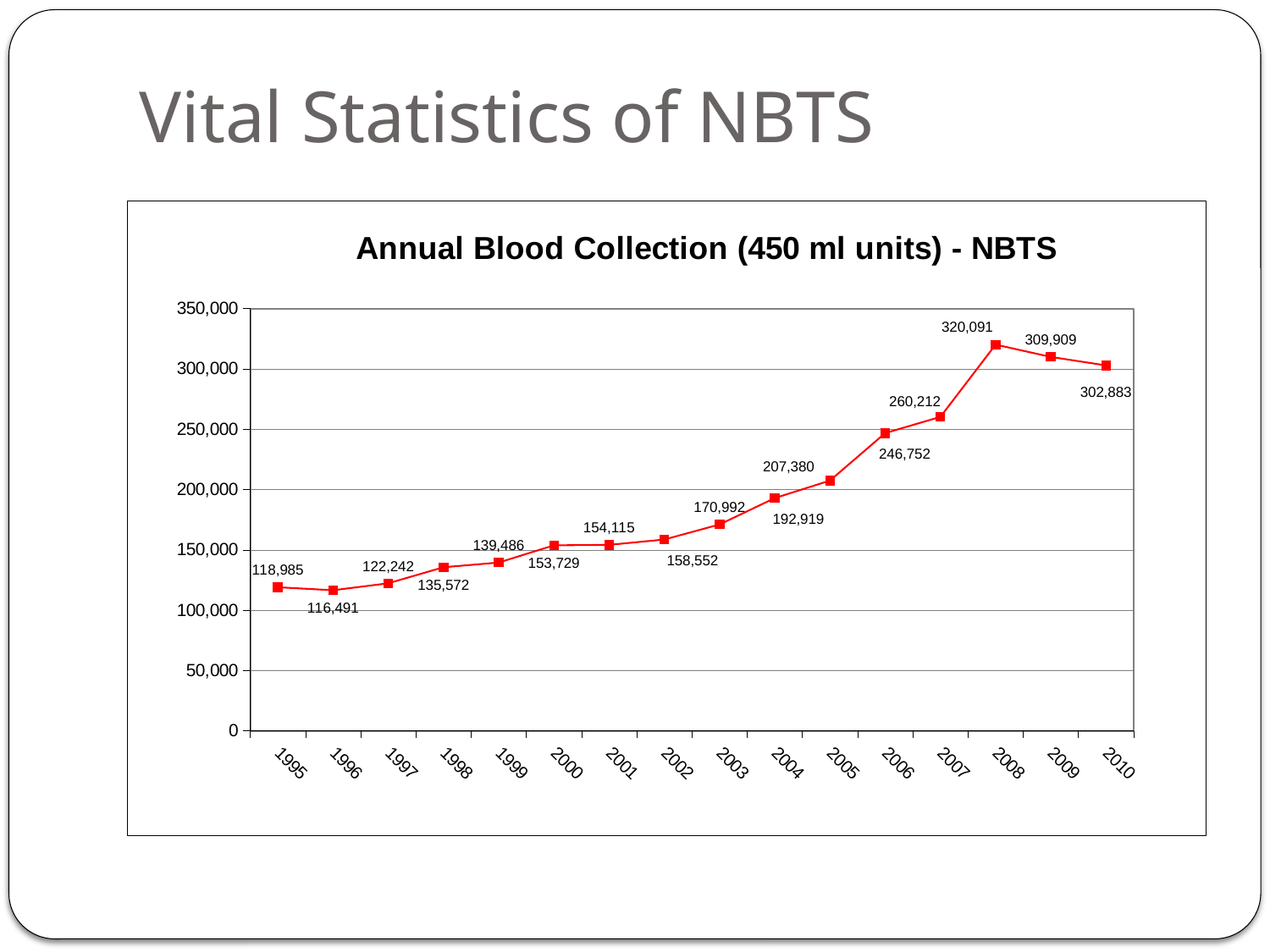
What is the difference between the 2009 and 2010 values? 7,026 What was the annual blood collection in 2008? 320,091 What value is shown for 1995? 118,985 How many years are plotted on the chart? 16 By how much did the annual blood collection increase from 2007 to 2008? 59,879 What is the title of the chart? Annual Blood Collection (450 ml units) - NBTS What was the annual blood collection in 2004? 192,919 Which year had the highest annual blood collection? 2008 Which year had the lowest annual blood collection? 1996 What kind of chart is shown on the slide? Line chart Which year had a higher blood collection, 2006 or 2005? 2006 Is the value for 2003 greater or less than 150,000? greater